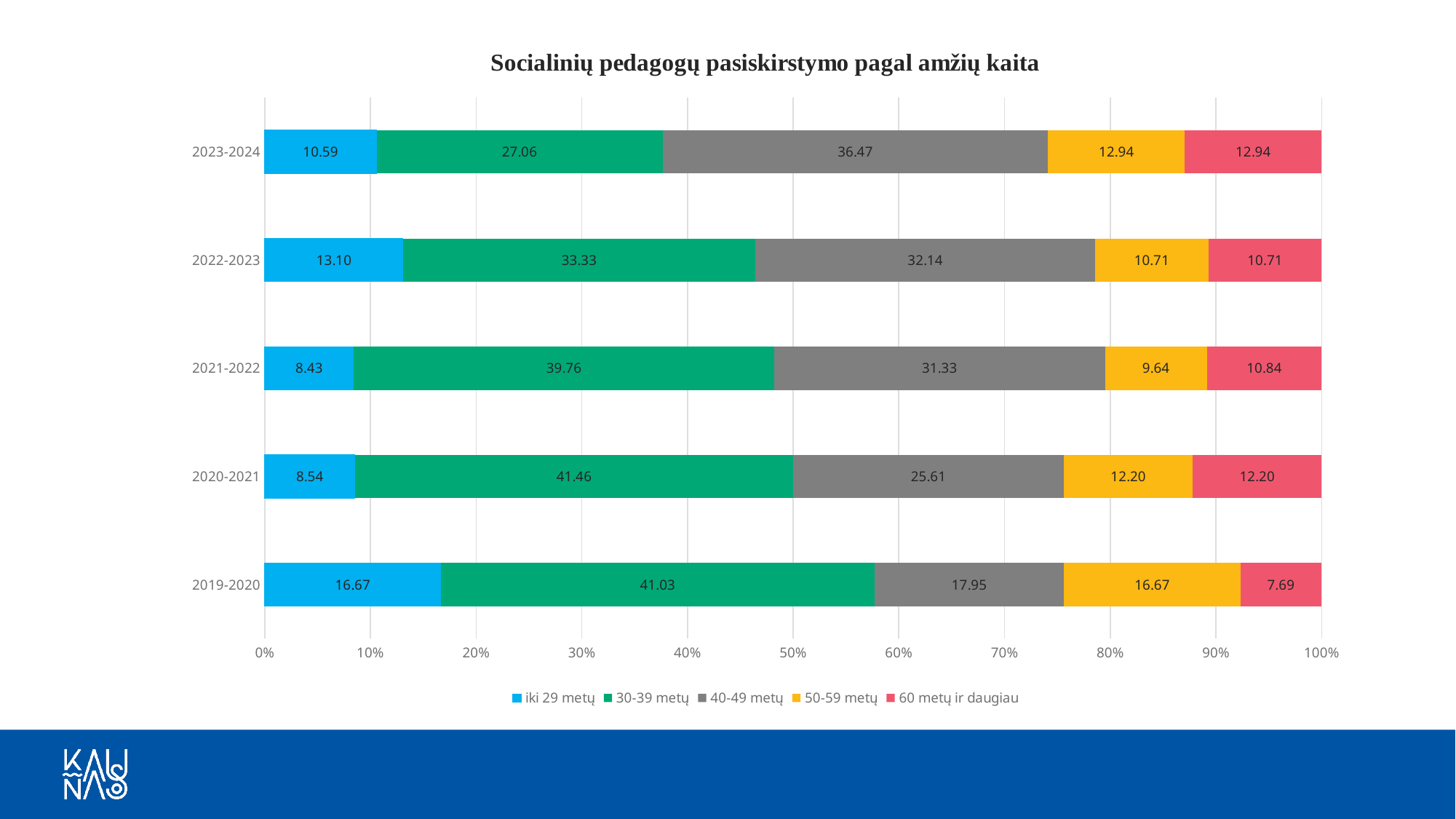
In which year is the '40-49 metų' value lowest? 2019-2020 What kind of chart is shown on the slide? Stacked bar chart How many series does the legend list? 5 How many years (categories) are shown on the chart? 5 What is the value for '60 metų ir daugiau' in 2021-2022? 10.84 What is the value for '40-49 metų' in 2023-2024? 36.47 Which is larger: the 'iki 29 metų' value in 2022-2023 or in 2023-2024? 2022-2023 What is the title of the chart? Socialinių pedagogų pasiskirstymo pagal amžių kaita In which year is the '30-39 metų' value highest? 2020-2021 What is the value for 'iki 29 metų' in 2019-2020? 16.67 What is the difference between the '40-49 metų' values for 2023-2024 and 2019-2020? 18.52 What is the value for '30-39 metų' in 2022-2023? 33.33